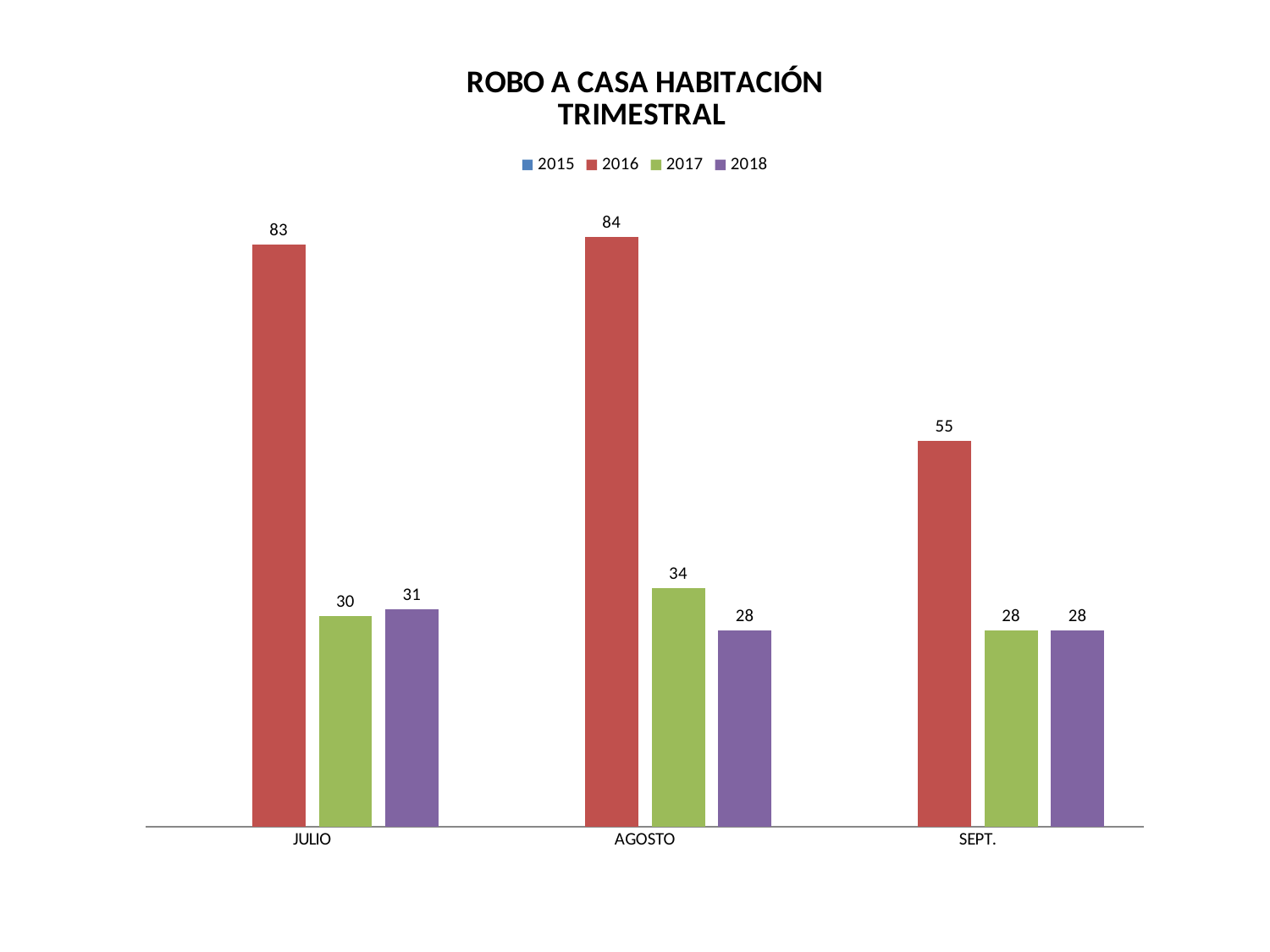
Which month has the highest value for 2016? AGOSTO What is the value for 2017 in AGOSTO? 34 Which month has the lowest value for 2016? SEPT. Which is larger, the 2017 value in AGOSTO or the 2018 value in AGOSTO? 2017 value in AGOSTO What is the value for 2018 in SEPT.? 28 What is the difference between the 2016 and 2017 values in JULIO? 53 What is the title of the chart? ROBO A CASA HABITACIÓN TRIMESTRAL What is the value for 2016 in JULIO? 83 What kind of chart is shown? bar chart What is the difference between the 2016 values for AGOSTO and SEPT.? 29 How many months are shown on the x axis? 3 How many series does the legend list? 4